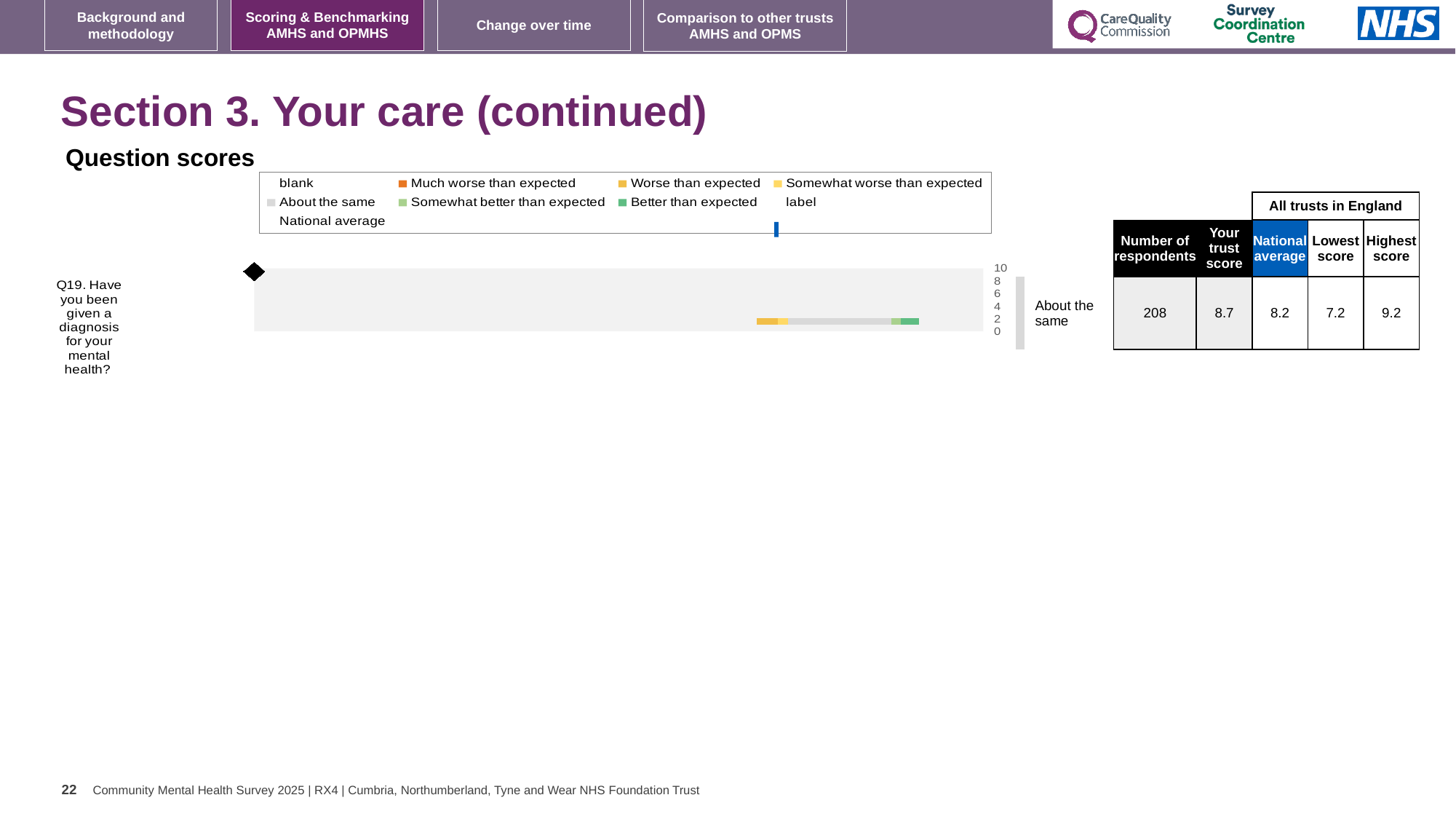
For Q19, which is larger: the trust's score or the national average? Your trust score For Q19, what is the difference between the highest score and the lowest score among all trusts in England? 2.0 Which question is plotted in the Question scores chart? Q19. Have you been given a diagnosis for your mental health? In the table beside the chart, what is the highest score among all trusts in England for Q19? 9.2 How many questions are plotted in the Question scores chart? 1 In the table beside the chart, what is the trust's score for Q19? 8.7 In the table beside the chart, what is the national average for Q19? 8.2 In the table beside the chart, what is the number of respondents for Q19? 208 For Q19, how much higher is the trust's score than the national average? 0.5 What kind of chart is used to show the Q19 question score? bar chart What rating label is shown to the right of the Q19 bar? About the same In the table beside the chart, what is the lowest score among all trusts in England for Q19? 7.2